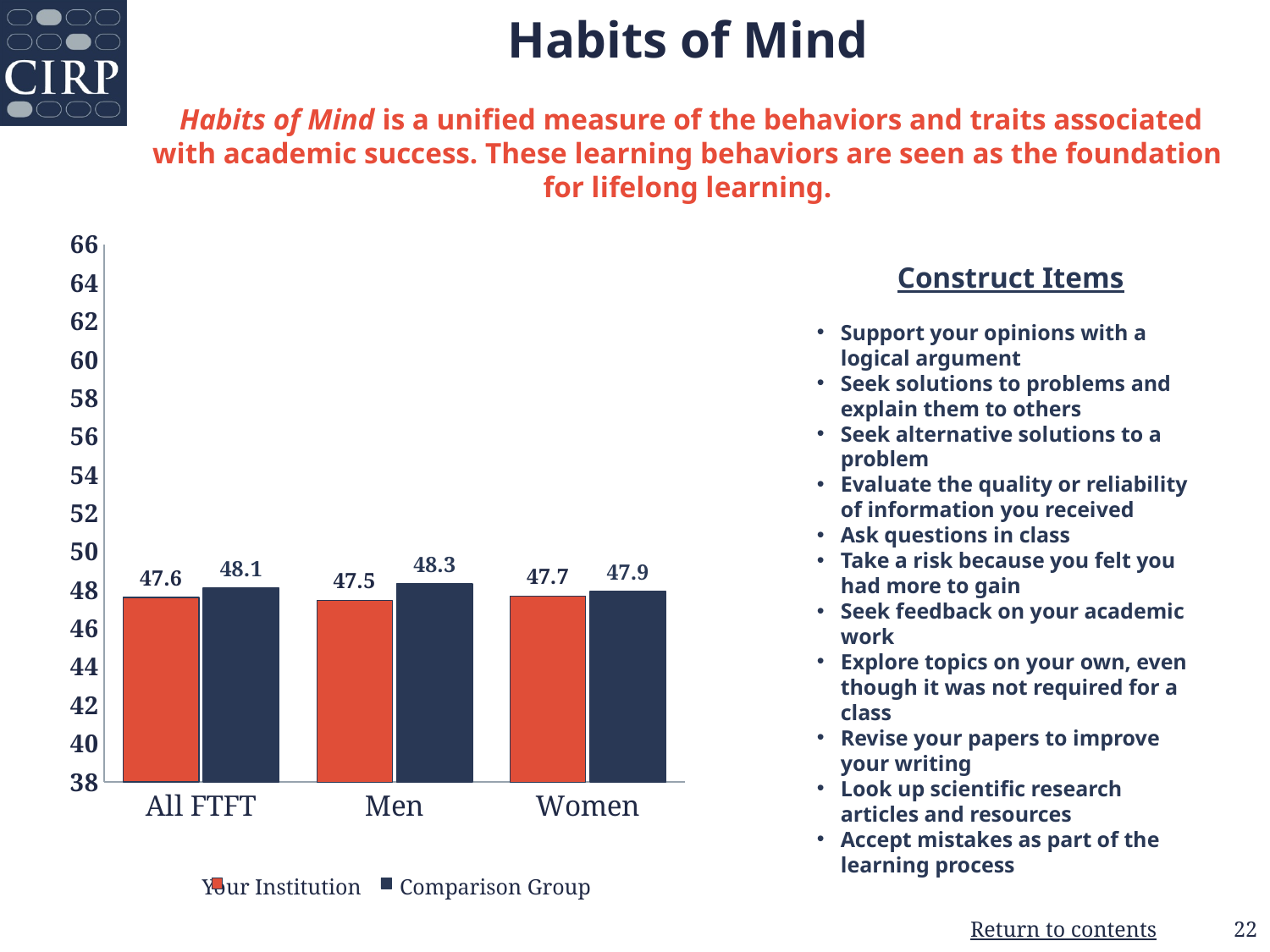
Which category has the highest Comparison Group value? Men What is the value for Your Institution in the All FTFT category? 47.6 How many series does the legend list? 2 What is the value for Your Institution in the Women category? 47.7 How many categories are shown on the x axis? 3 What is the difference between the Comparison Group and Your Institution values for All FTFT? 0.5 What is the difference between the Comparison Group and Your Institution values for Men? 0.8 What is the value for the Comparison Group in the Women category? 47.9 What kind of chart is shown on the slide? Bar chart Which category has the lowest Your Institution value? Men What is the value for the Comparison Group in the Men category? 48.3 Which is larger for Men: Your Institution or the Comparison Group? Comparison Group